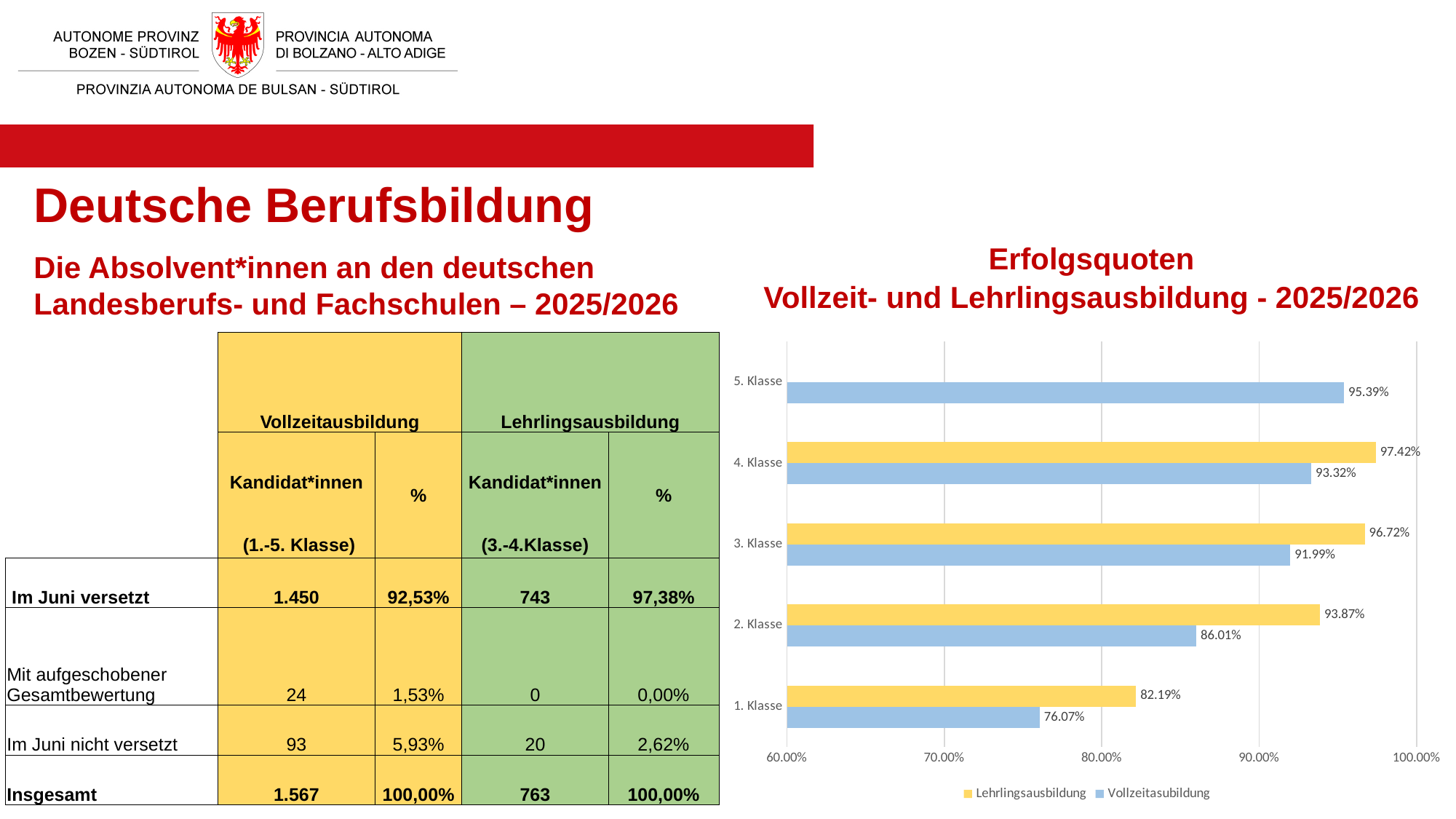
For 3. Klasse, which is larger: the Lehrlingsausbildung value or the Vollzeitasubildung value? Lehrlingsausbildung How many series does the chart legend list? 2 How many Klasse categories are shown on the chart's vertical axis? 5 Which Klasse has the highest Lehrlingsausbildung value in the chart? 4. Klasse Which Klasse has the lowest Vollzeitasubildung value in the chart? 1. Klasse What is the Lehrlingsausbildung value for 4. Klasse in the chart? 97.42% What is the difference between the Lehrlingsausbildung and Vollzeitasubildung values for 2. Klasse? 7.86% Is the Vollzeitasubildung value for 2. Klasse greater or less than 90.00%? less What is the Vollzeitasubildung value for 5. Klasse in the chart? 95.39% What type of chart is shown on the slide? bar chart Which colour represents Lehrlingsausbildung in the chart? yellow What is the Vollzeitasubildung value for 1. Klasse in the chart? 76.07%